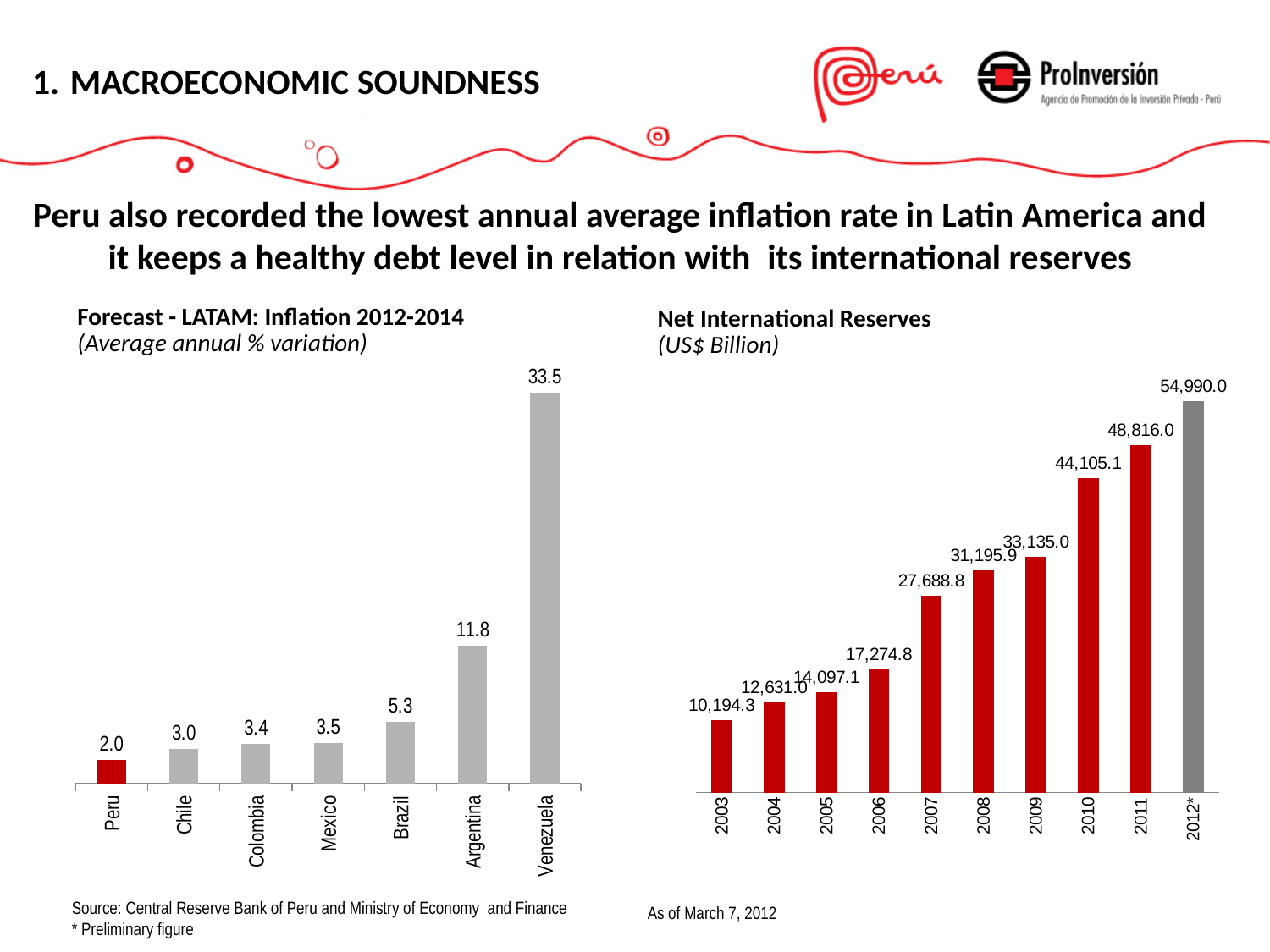
In the Net International Reserves chart, which year has the lowest value? 2003 In the Net International Reserves chart, what is the value for 2012*? 54,990.0 In the Forecast - LATAM: Inflation 2012-2014 chart, which is larger, the value for Mexico or the value for Colombia? Mexico In the Net International Reserves chart, what is the value for 2007? 27,688.8 In the Forecast - LATAM: Inflation 2012-2014 chart, which country has the highest value? Venezuela In the Forecast - LATAM: Inflation 2012-2014 chart, what is the value for Peru? 2.0 In the Forecast - LATAM: Inflation 2012-2014 chart, what is the difference between the values for Argentina and Brazil? 6.5 What type of chart is the Net International Reserves chart? Bar chart In the Forecast - LATAM: Inflation 2012-2014 chart, which country has the lowest value? Peru In the Forecast - LATAM: Inflation 2012-2014 chart, how many countries are shown? 7 In the Net International Reserves chart, what is the difference between the values for 2011 and 2010? 4,710.9 In the Net International Reserves chart, do the values rise or fall from 2003 to 2012*? Rise